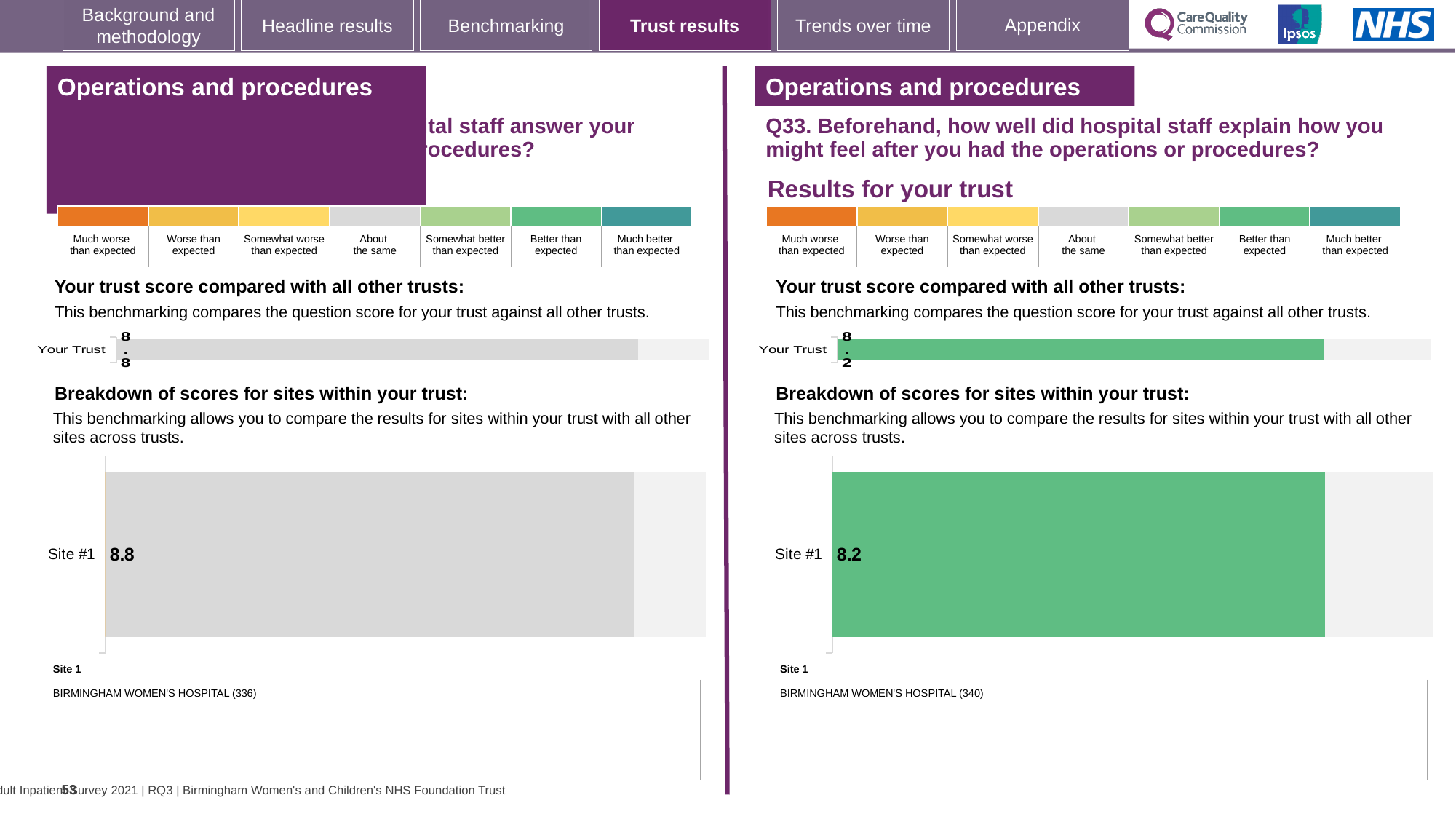
Which site name is listed as Site 1 on the right-hand side of the slide? BIRMINGHAM WOMEN'S HOSPITAL (340) Which is larger: the Site #1 score on the left-hand chart or the Site #1 score on the right-hand chart? Left-hand chart (8.8) How many sites are shown in the right-hand breakdown of scores for sites within your trust? 1 In the right-hand breakdown of scores for sites within your trust, what is the score for Site #1? 8.2 What type of chart is used to show the Your Trust score on the right-hand side? Bar chart On the right-hand chart for Q33, what is the score shown for Your Trust? 8.2 How many sites are shown in the left-hand breakdown of scores for sites within your trust? 1 What colour is the Site #1 bar on the right-hand chart for Q33? Green Is the Your Trust score on the right-hand chart greater or less than 8.5? less On the left-hand chart, what is the score shown for Your Trust? 8.8 In the left-hand breakdown of scores for sites within your trust, what is the score for Site #1? 8.8 What is the difference between the Your Trust score on the left-hand chart and the Your Trust score on the right-hand chart? 0.6